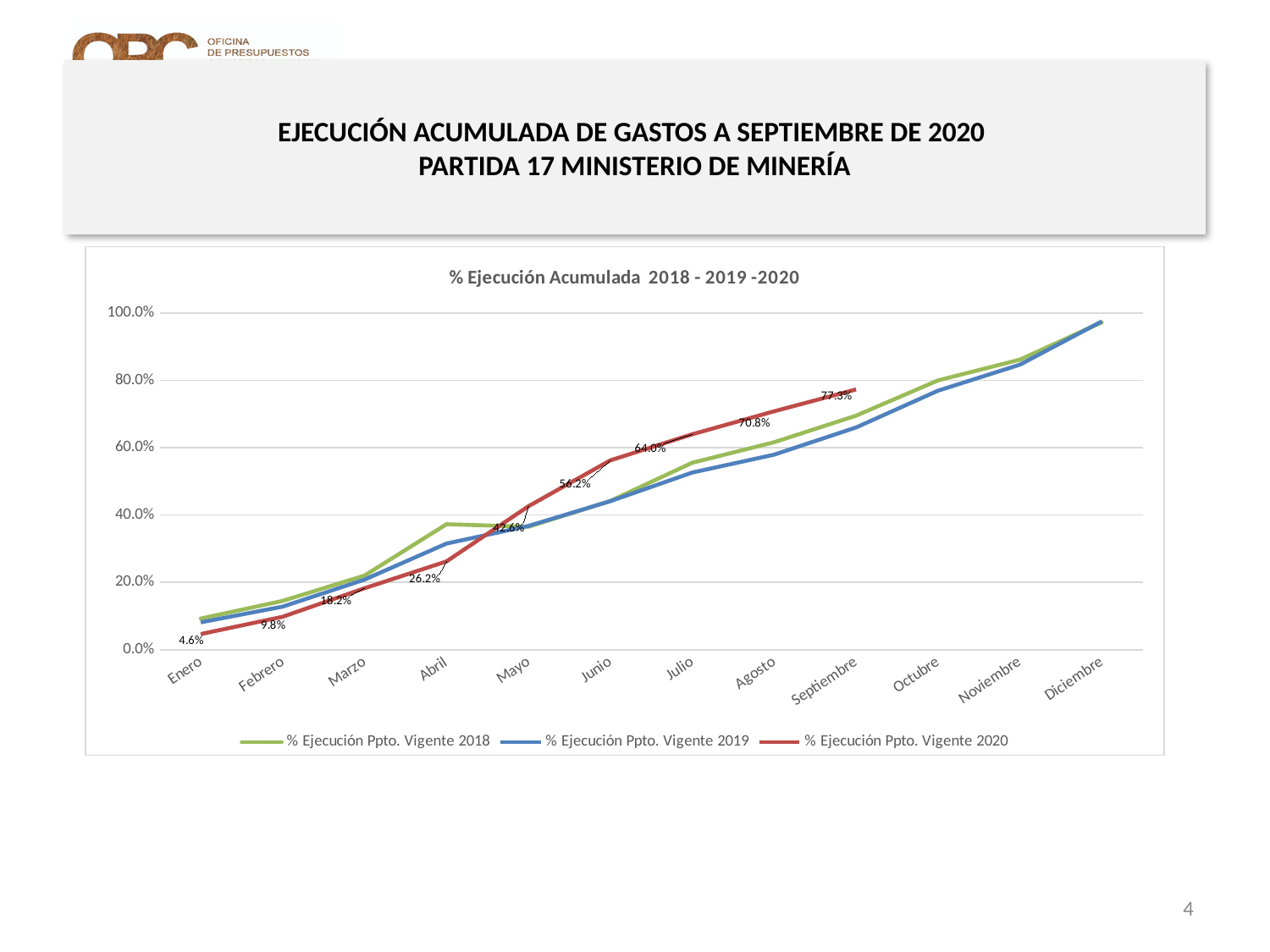
What is the value of % Ejecución Ppto. Vigente 2020 for Enero? 4.6% What is the title of the chart? % Ejecución Acumulada 2018 - 2019 -2020 Is the value of % Ejecución Ppto. Vigente 2019 for Diciembre greater or less than 80.0%? greater What is the value of % Ejecución Ppto. Vigente 2020 for Septiembre? 77.3% How many months are shown along the x axis? 12 Is the value of % Ejecución Ppto. Vigente 2018 for Abril greater or less than 40.0%? less What is the value of % Ejecución Ppto. Vigente 2020 for Mayo? 42.6% What is the difference between the 2020 values for Junio and Mayo? 13.6% What kind of chart is shown on the slide? line chart How many series does the legend list? 3 What is the difference between the 2020 values for Septiembre and Agosto? 6.5% Do the values of % Ejecución Ppto. Vigente 2020 rise or fall from Enero to Septiembre? rise